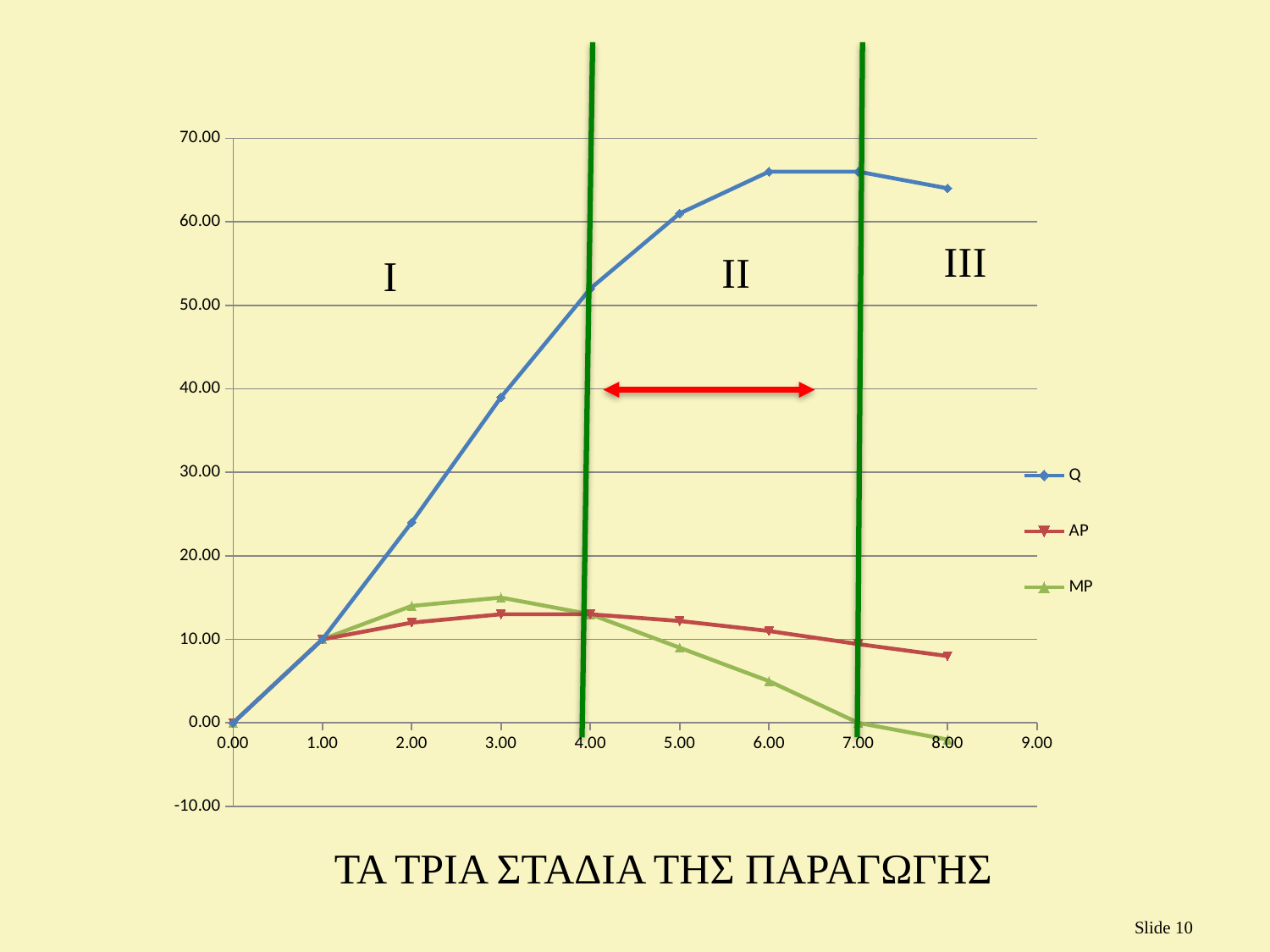
Does the Q series rise or fall between 0.00 and 6.00 on the x axis? rise Is the value of AP at 8.00 greater or less than 10.00? less What are the series names listed in the legend? Q, AP, MP Is the value of MP at 8.00 greater or less than 0.00? less Is the value of Q at 3.00 greater or less than 30.00? greater What kind of chart is shown on the slide? line chart At 5.00 on the x axis, which series has the larger value, Q or AP? Q Does the MP series rise or fall between 3.00 and 8.00 on the x axis? fall How many series does the legend list? 3 Which series reaches the highest value on the chart? Q At which x value does the MP series reach its highest point? 3.00